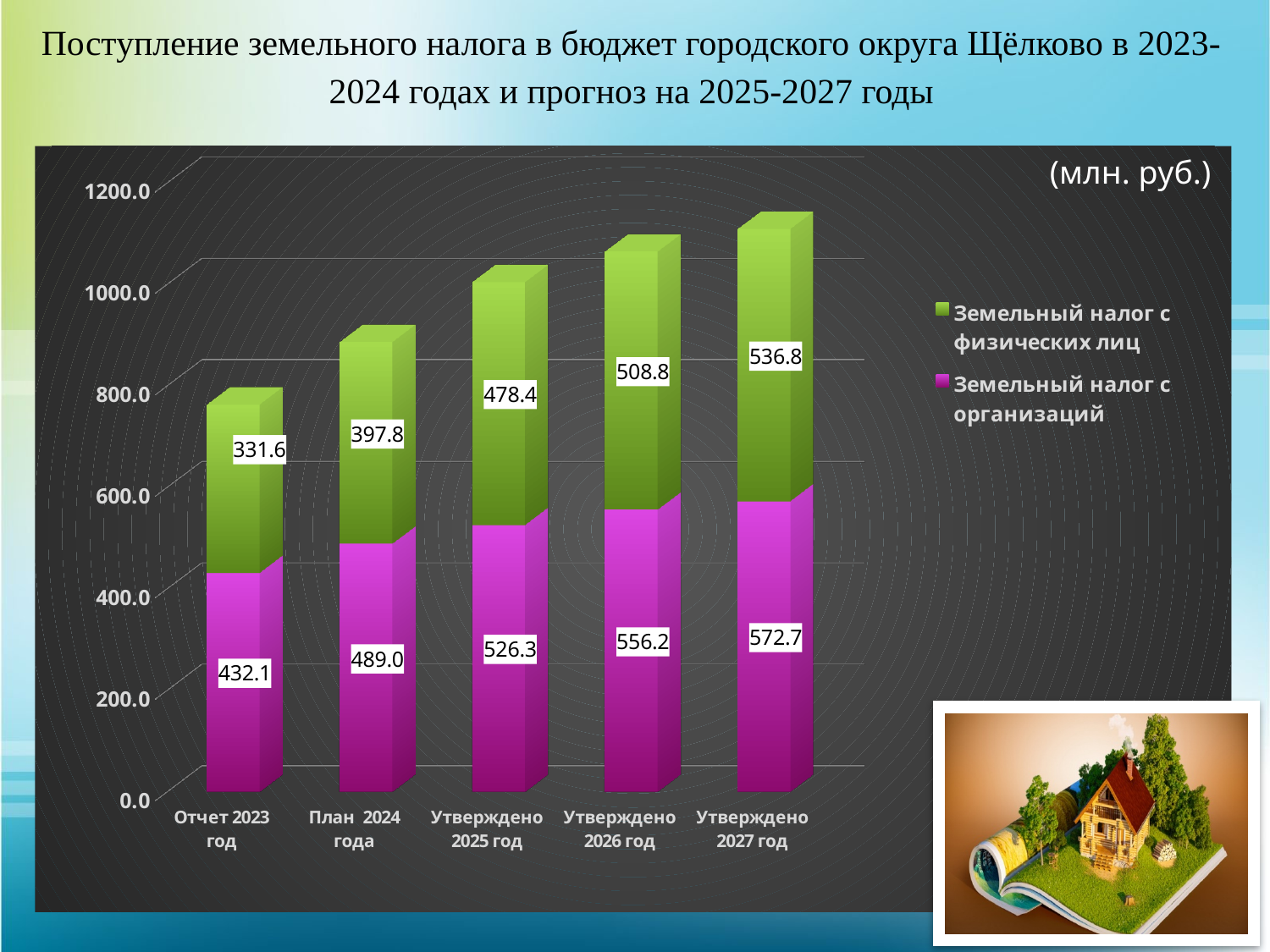
How many series does the legend list? 2 What is the difference between 'Земельный налог с организаций' for 'Утверждено 2026 год' and 'Утверждено 2025 год'? 29.9 What is the value of 'Земельный налог с физических лиц' for 'План 2024 года'? 397.8 What is the total of the stacked bar for 'Отчет 2023 год'? 763.7 What is the value of 'Земельный налог с физических лиц' for 'Утверждено 2027 год'? 536.8 Which is larger for 'Утверждено 2025 год': 'Земельный налог с физических лиц' or 'Земельный налог с организаций'? Земельный налог с организаций Do the values for 'Земельный налог с физических лиц' rise or fall from 'Отчет 2023 год' to 'Утверждено 2027 год'? rise How many categories are shown on the x axis? 5 What is the value of 'Земельный налог с организаций' for 'Отчет 2023 год'? 432.1 What is the total of the stacked bar for 'Утверждено 2027 год'? 1109.5 Which category has the highest value for 'Земельный налог с организаций'? Утверждено 2027 год Which category has the lowest value for 'Земельный налог с физических лиц'? Отчет 2023 год